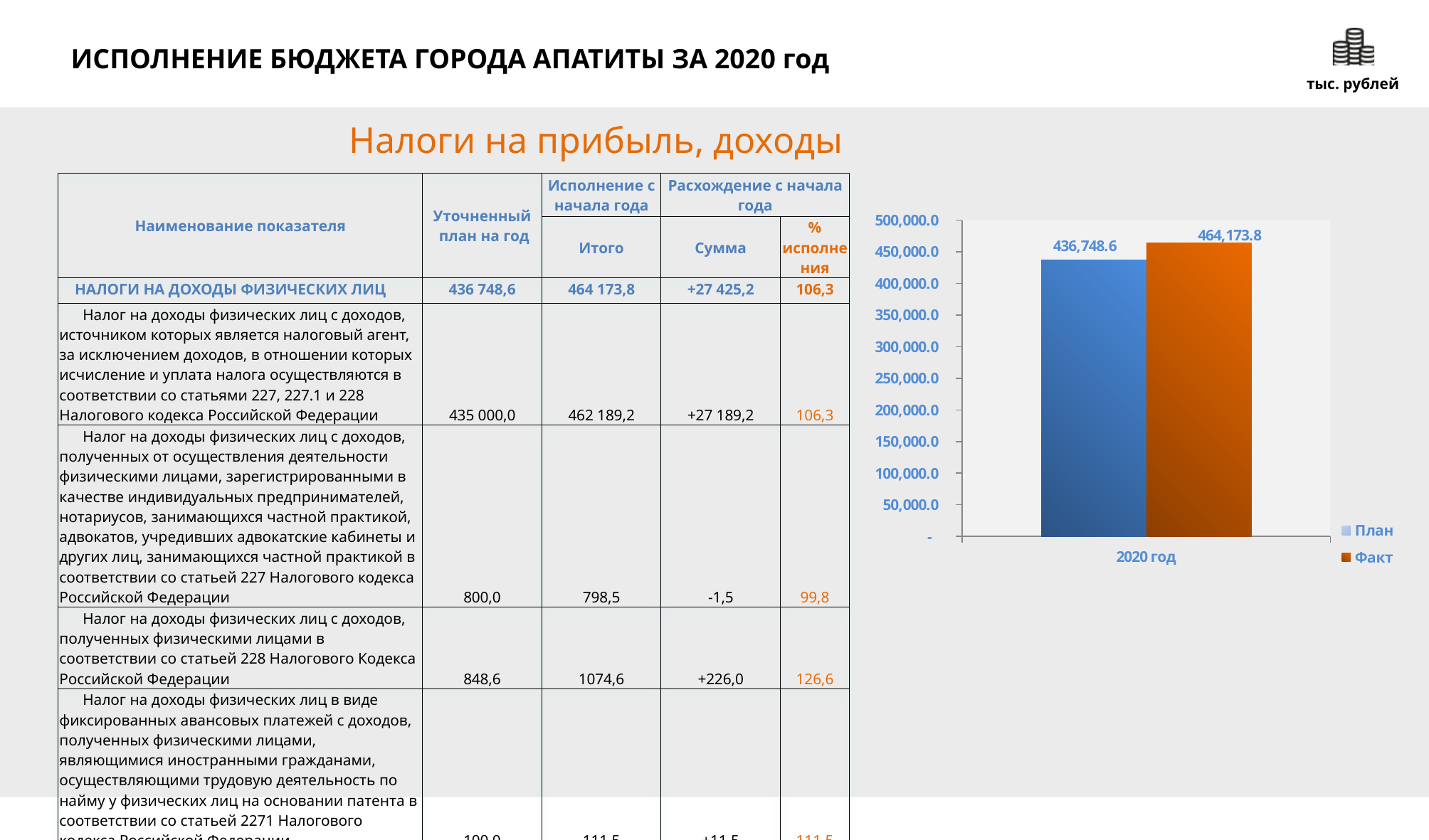
What is the value of the Факт bar for 2020 год in the chart? 464,173.8 Is the value of the План bar greater or less than 450,000.0? less How many series does the chart legend list? 2 What is the category label on the x axis of the chart? 2020 год What is the value of the План bar for 2020 год in the chart? 436,748.6 How many categories are shown on the x axis of the chart? 1 Which series has the lowest bar in the chart? План Which series has the highest bar in the chart? Факт Is the value of the Факт bar greater or less than 450,000.0? greater What kind of chart is shown on the slide? bar chart What is the difference between the Факт and План values in the chart? 27,425.2 Which series has the higher value in the chart, План or Факт? Факт